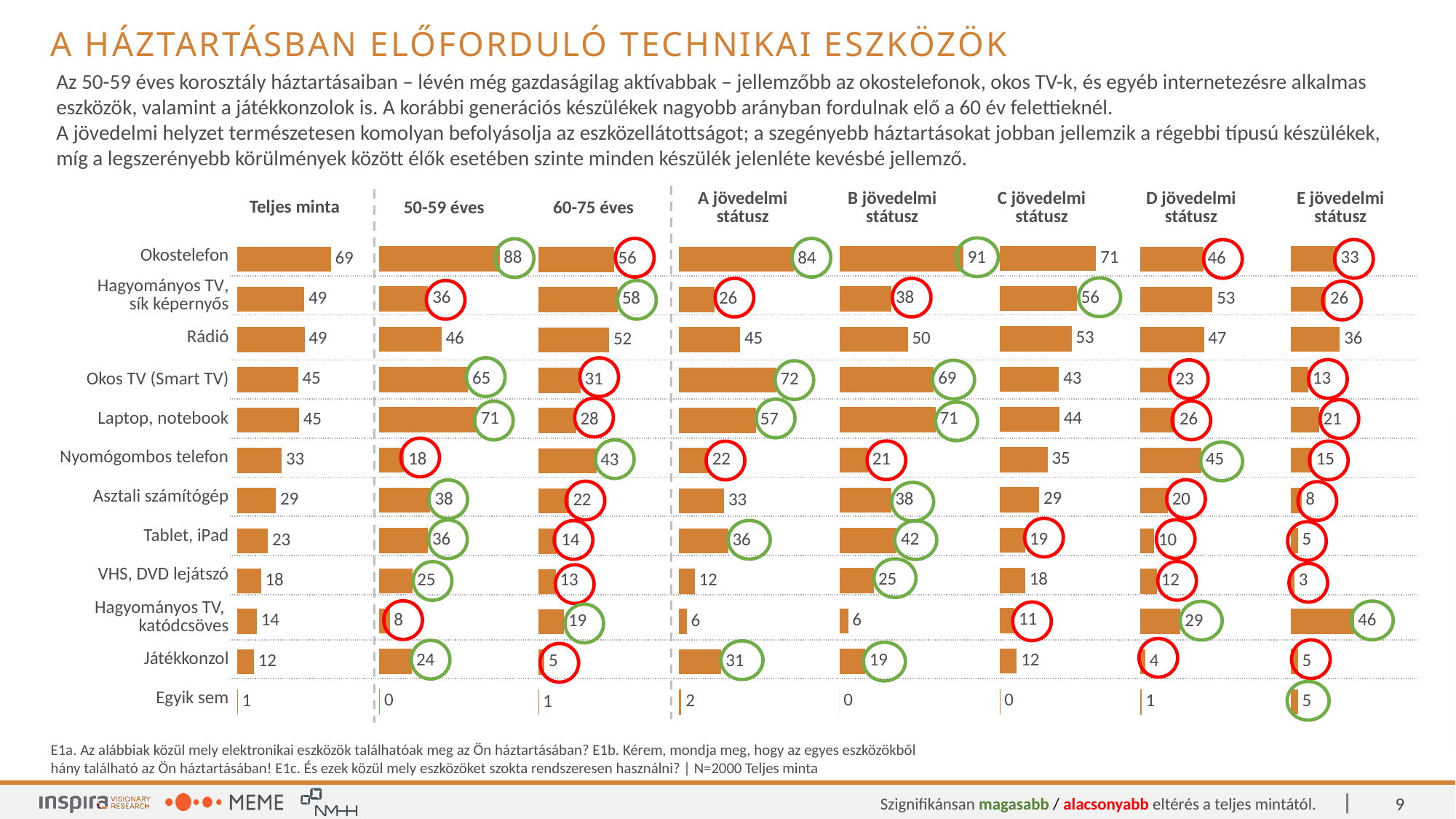
In the "B jövedelmi státusz" chart, which category has the highest value? Okostelefon In the "D jövedelmi státusz" chart, which is larger: Nyomógombos telefon or Okos TV (Smart TV)? Nyomógombos telefon How many categories are listed in each chart on the slide? 12 What is the difference between the Okostelefon values in the "50-59 éves" chart and the "60-75 éves" chart? 32 In the "60-75 éves" chart, which category has the lowest value? Egyik sem In the "Teljes minta" chart, what is the value for Okostelefon? 69 In the "E jövedelmi státusz" chart, what is the value for Hagyományos TV, katódcsöves? 46 According to the legend at the bottom, what does a green circle indicate? Szignifikánsan magasabb eltérés a teljes mintától In the "50-59 éves" chart, what is the value for Laptop, notebook? 71 In the "A jövedelmi státusz" chart, what is the value for Játékkonzol? 31 What type of chart is used in the "Teljes minta" column? Bar chart In the "C jövedelmi státusz" chart, what is the difference between Rádió and Tablet, iPad? 34